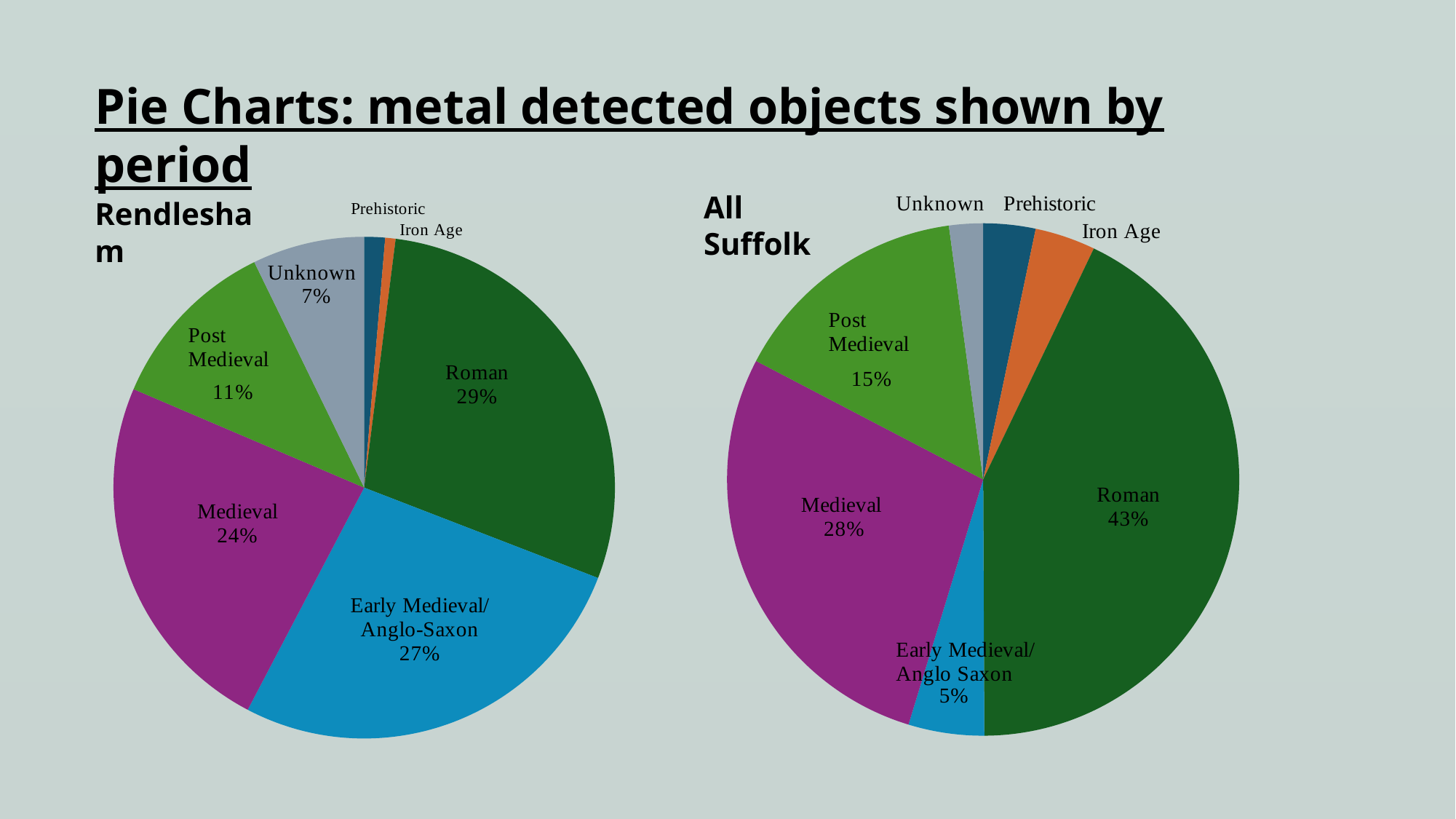
In the Rendlesham pie chart, what share of objects is Roman? 29% In the All Suffolk pie chart, what share of objects is Post Medieval? 15% Is the Medieval share larger in the Rendlesham pie chart or the All Suffolk pie chart? All Suffolk In the All Suffolk pie chart, which period has the largest share? Roman In the Rendlesham pie chart, which period has the largest share? Roman In the Rendlesham pie chart, what share of objects is Early Medieval/Anglo-Saxon? 27% What kind of charts are shown on the slide? Pie charts In the Rendlesham pie chart, which period has the smallest share? Iron Age How many percentage points larger is the Roman share in the All Suffolk pie chart than in the Rendlesham pie chart? 14 How many period categories does the Rendlesham pie chart show? 7 In the All Suffolk pie chart, what share of objects is Roman? 43% In the All Suffolk pie chart, what share of objects is Early Medieval/Anglo Saxon? 5%